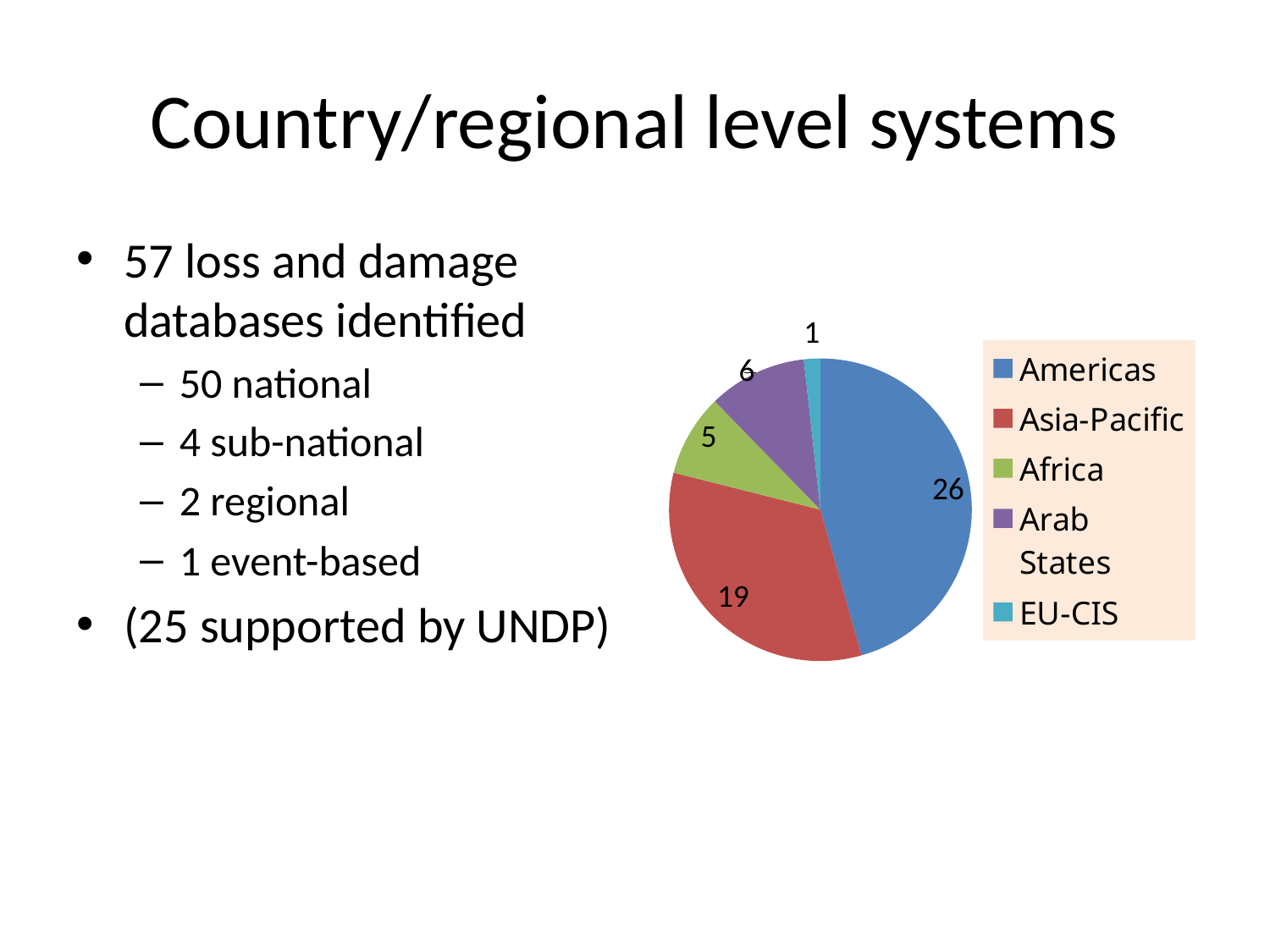
How many slices does the pie chart have? 5 What value is shown for the Africa slice of the pie chart? 5 Which region has the smallest slice in the pie chart? EU-CIS What type of chart is shown on the slide? Pie chart What is the total of all the values shown in the pie chart? 57 Which region has the largest slice in the pie chart? Americas What value is shown for the Arab States slice of the pie chart? 6 What value is shown for the Americas slice of the pie chart? 26 What value is shown for the EU-CIS slice of the pie chart? 1 Which is larger in the pie chart, Arab States or Africa? Arab States What value is shown for the Asia-Pacific slice of the pie chart? 19 What is the difference between the Americas value and the Asia-Pacific value in the pie chart? 7